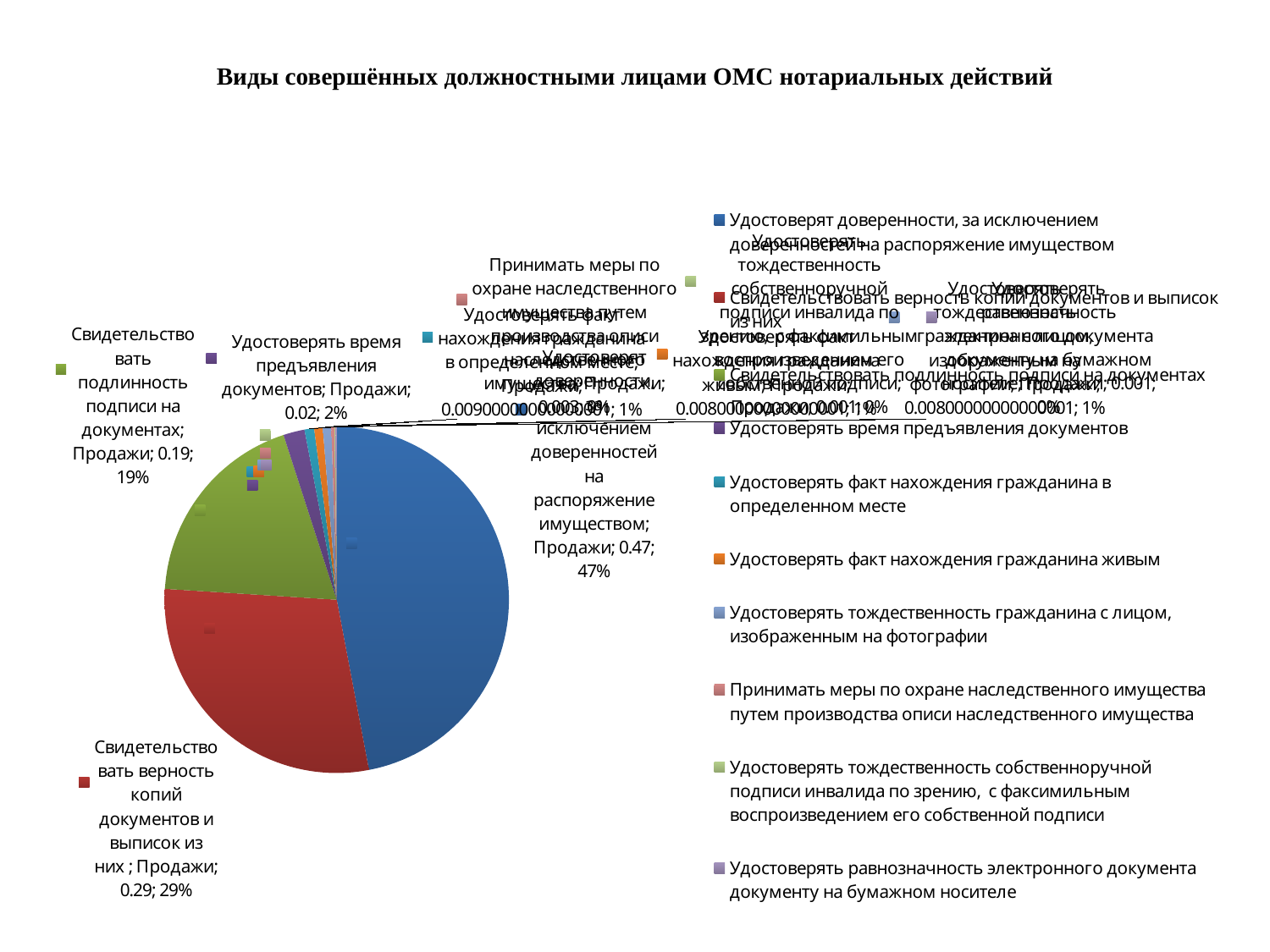
What is the difference in percentage points between the 47% slice and the 29% slice? 18 What value is printed for "Свидетельствовать верность копий документов и выписок из них" before its percentage? 0.29 What type of chart is shown on the slide? pie chart What percentage share does the slice "Удостоверят доверенности, за исключением доверенностей на распоряжение имуществом" have? 47% What colour is the largest slice of the pie? blue What percentage share does the slice "Свидетельствовать подлинность подписи на документах" have? 19% Which slice is larger: "Свидетельствовать подлинность подписи на документах" or "Свидетельствовать верность копий документов и выписок из них"? Свидетельствовать верность копий документов и выписок из них What percentage share does the slice "Удостоверять время предъявления документов" have? 2% What is the title of the chart? Виды совершённых должностными лицами ОМС нотариальных действий Which category has the largest slice of the pie? Удостоверят доверенности, за исключением доверенностей на распоряжение имуществом How many entries does the legend list? 10